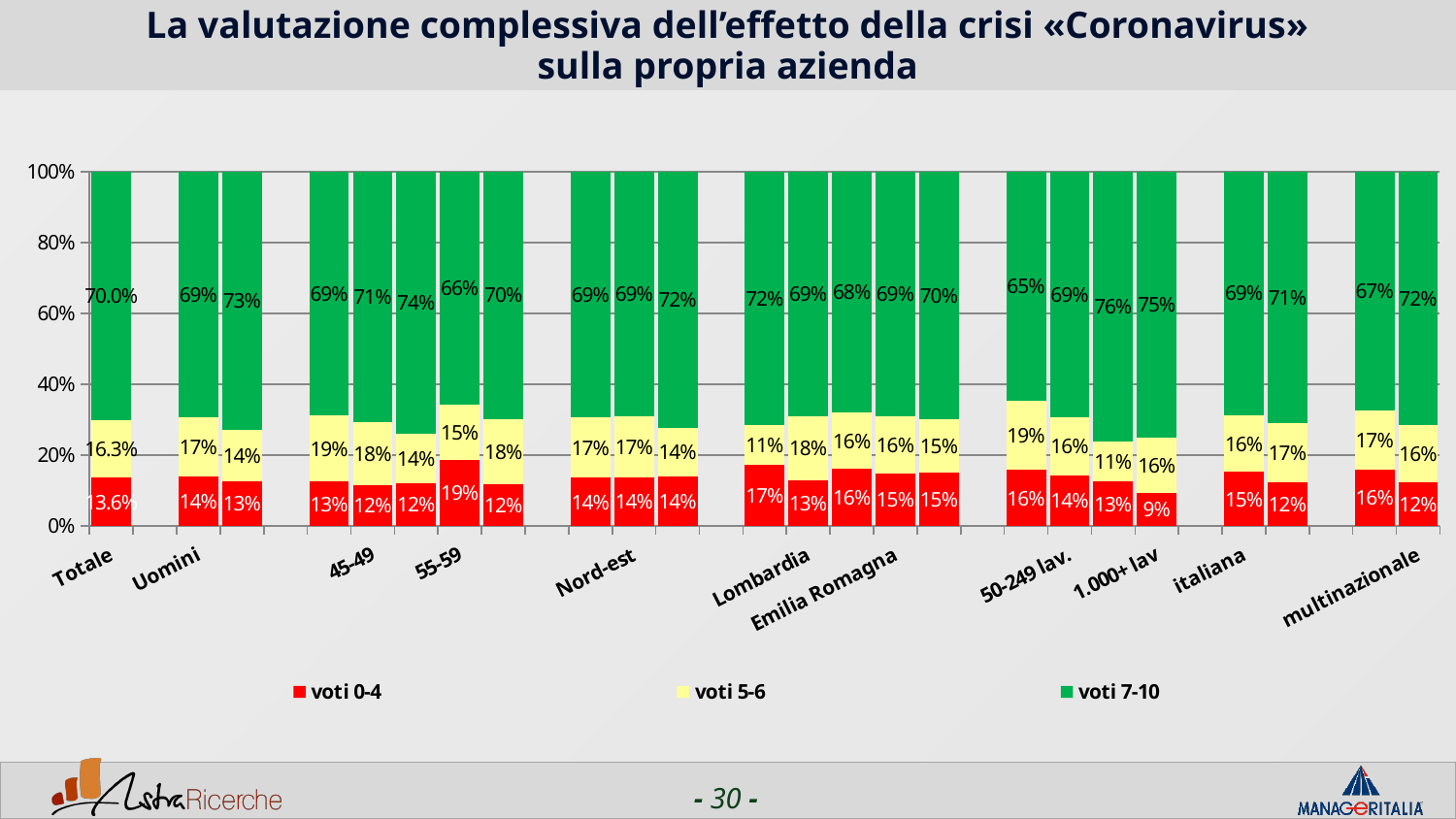
What is the value of 'voti 7-10' for the 'Totale' bar? 70.0% What is the value of 'voti 0-4' for the 'Totale' bar? 13.6% How many series does the legend list? 3 What colour represents the 'voti 0-4' series? Red What is the difference in percentage points between the 'voti 0-4' value for 'Uomini' and for '1.000+ lav'? 5 percentage points What is the value of 'voti 0-4' for '1.000+ lav'? 9% Which has a larger 'voti 7-10' value, 'Totale' or 'Uomini'? Totale What is the value of 'voti 5-6' for 'Uomini'? 17% Is the 'voti 7-10' value for 'Totale' greater or less than 60%? greater What is the value of 'voti 7-10' for 'multinazionale'? 72% What are the three legend entries of the chart? voti 0-4, voti 5-6, voti 7-10 What kind of chart is shown on the slide? Stacked bar chart